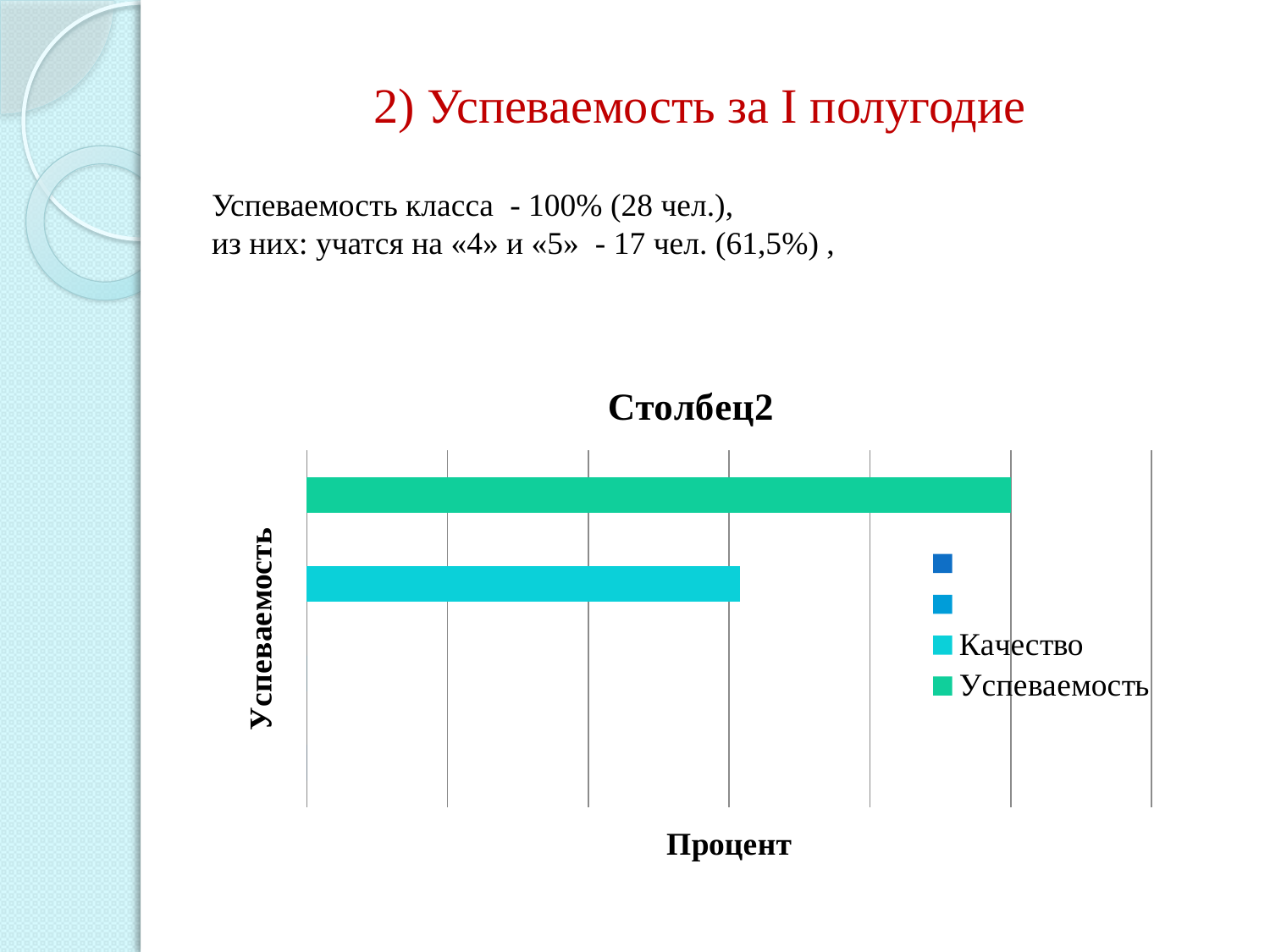
What kind of chart is shown on the slide? Bar chart What is the label on the horizontal axis of the chart? Процент Which series is drawn in green in the chart? Успеваемость Which series has the longer bar, Качество or Успеваемость? Успеваемость Is the bar for Качество longer or shorter than the bar for Успеваемость? Shorter How many named series does the chart legend list? 2 How many bars are plotted in the chart? 2 Which series has the shorter bar in the chart? Качество What is the title of the chart? Столбец2